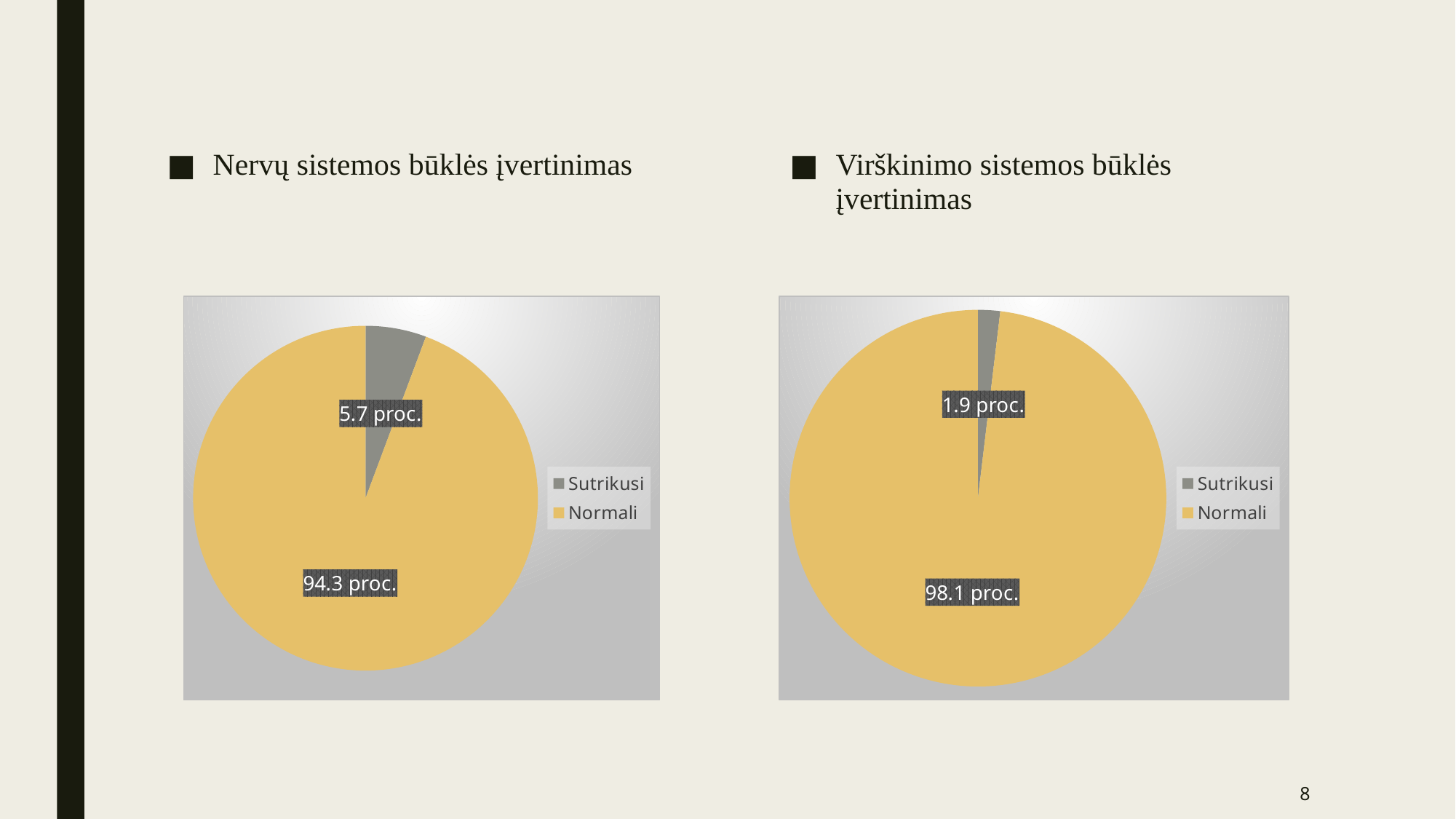
In the left pie chart (Nervų sistemos būklės įvertinimas), what is the value for Sutrikusi? 5.7 proc. In the left pie chart (Nervų sistemos būklės įvertinimas), what is the value for Normali? 94.3 proc. In the left pie chart (Nervų sistemos būklės įvertinimas), what is the difference between the Normali and Sutrikusi values? 88.6 proc. What type of chart is used on the right (Virškinimo sistemos būklės įvertinimas)? Pie chart How many slices does the left pie chart (Nervų sistemos būklės įvertinimas) have? 2 In the left pie chart (Nervų sistemos būklės įvertinimas), which category has the largest share? Normali In the right pie chart (Virškinimo sistemos būklės įvertinimas), what colour represents Normali? Yellow In the right pie chart (Virškinimo sistemos būklės įvertinimas), what is the difference between the Normali and Sutrikusi values? 96.2 proc. Which chart has the larger Sutrikusi share, the left one (Nervų sistemos) or the right one (Virškinimo sistemos)? The left one (Nervų sistemos) In the right pie chart (Virškinimo sistemos būklės įvertinimas), which category has the smallest share? Sutrikusi In the right pie chart (Virškinimo sistemos būklės įvertinimas), what is the value for Sutrikusi? 1.9 proc. In the right pie chart (Virškinimo sistemos būklės įvertinimas), what is the value for Normali? 98.1 proc.